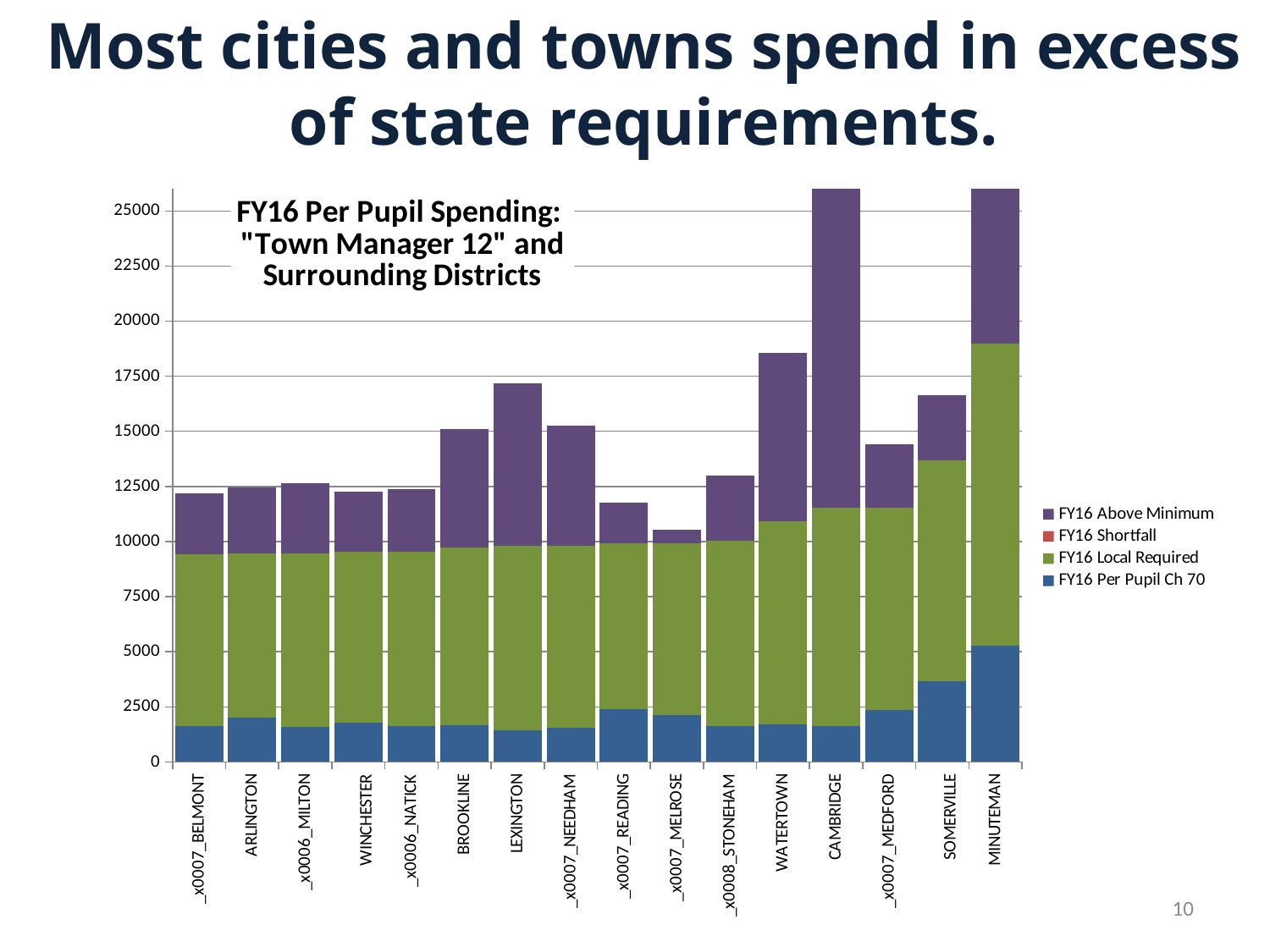
Is the total per pupil spending for WATERTOWN greater or less than 17500? greater Is the total per pupil spending for _x0007_READING greater or less than 12500? less What kind of chart is shown on the slide? Stacked bar chart How many districts (categories) are plotted along the x axis? 16 Is the total per pupil spending for CAMBRIDGE greater or less than 25000? greater What is the title of the chart? FY16 Per Pupil Spending: "Town Manager 12" and Surrounding Districts Which district has the lowest total per pupil spending? _x0007_MELROSE Which has the larger total per pupil spending, LEXINGTON or BROOKLINE? LEXINGTON Which district has the largest FY16 Per Pupil Ch 70 segment? MINUTEMAN How many series does the legend list? 4